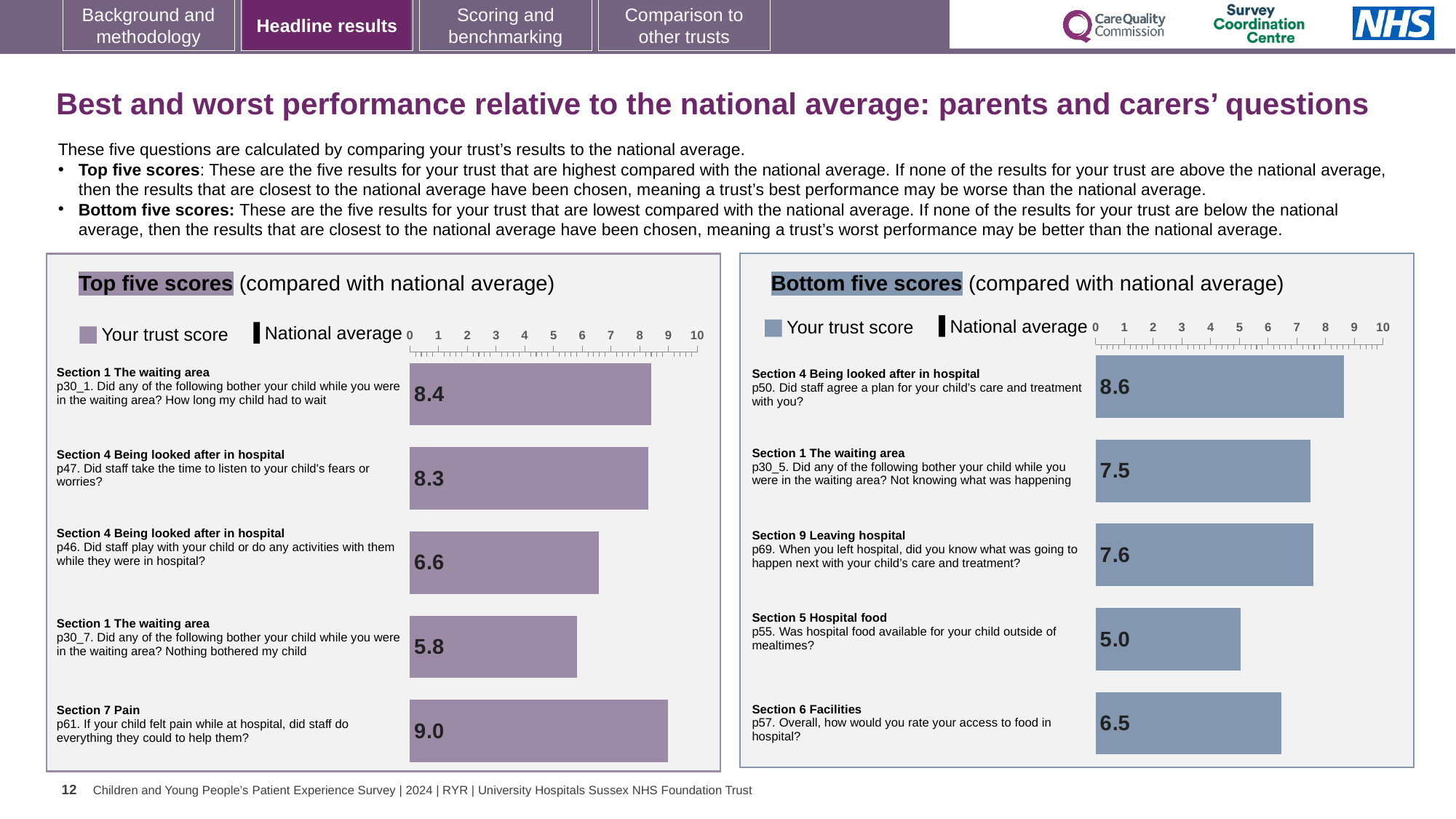
In the Top five scores chart, what is the difference between the trust scores for p61 and p30_7? 3.2 In the Top five scores chart, which question has the lowest trust score? p30_7 (Nothing bothered my child) In the Bottom five scores chart, which question has the highest trust score? p50 (Did staff agree a plan for your child's care and treatment with you?) In the Bottom five scores chart, what is the trust score for p55 (Was hospital food available for your child outside of mealtimes?)? 5.0 What type of chart is the Top five scores chart? Bar chart In the Top five scores chart, which question has the highest trust score? p61 (Section 7 Pain) In the Bottom five scores chart, which question has the lowest trust score? p55 (Was hospital food available for your child outside of mealtimes?) In the Top five scores chart, what is the trust score for p46 (Did staff play with your child or do any activities with them while they were in hospital?)? 6.6 In the Bottom five scores chart, what is the trust score for p69 (When you left hospital, did you know what was going to happen next with your child's care and treatment?)? 7.6 In the Top five scores chart, what is the trust score for p61 (If your child felt pain while at hospital, did staff do everything they could to help them?)? 9.0 In the Bottom five scores chart, which has the larger trust score: p30_5 or p57? p30_5 How many questions are plotted in the Bottom five scores chart? 5